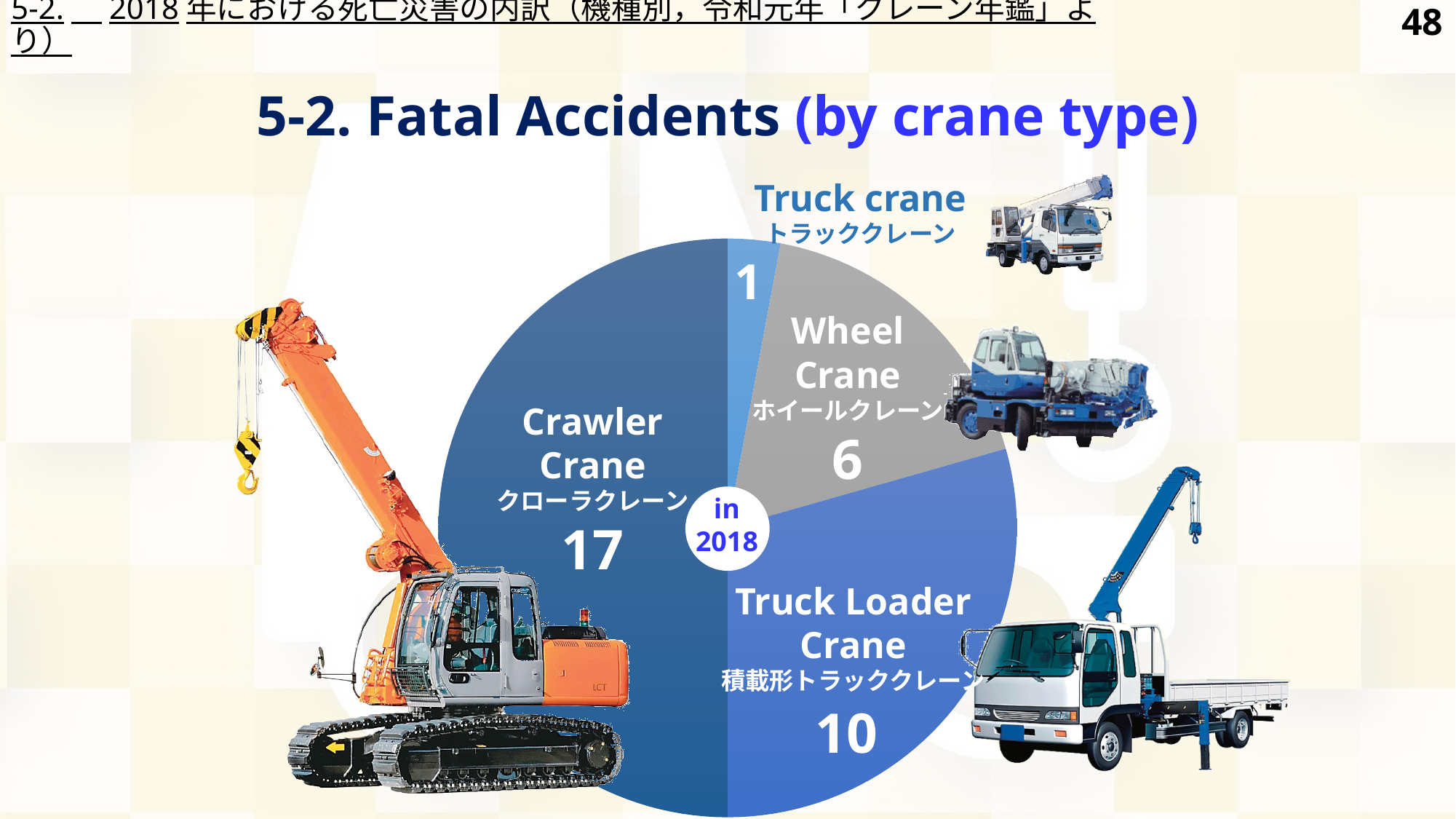
How many fatal accidents are attributed to the Truck Loader Crane? 10 How many fatal accidents are attributed to the Truck crane? 1 What kind of chart is shown on the slide? pie chart Which has more fatal accidents, the Wheel Crane or the Truck Loader Crane? Truck Loader Crane What is the total number of fatal accidents across all crane types in the pie chart? 34 How many fatal accidents are attributed to the Crawler Crane? 17 How many fatal accidents are attributed to the Wheel Crane? 6 Which crane type has the highest number of fatal accidents? Crawler Crane What is the difference between the fatal accidents for the Crawler Crane and the Truck Loader Crane? 7 How many crane types are shown in the pie chart? 4 Which crane type has the lowest number of fatal accidents? Truck crane What share of the total fatal accidents does the Crawler Crane slice represent? 50%